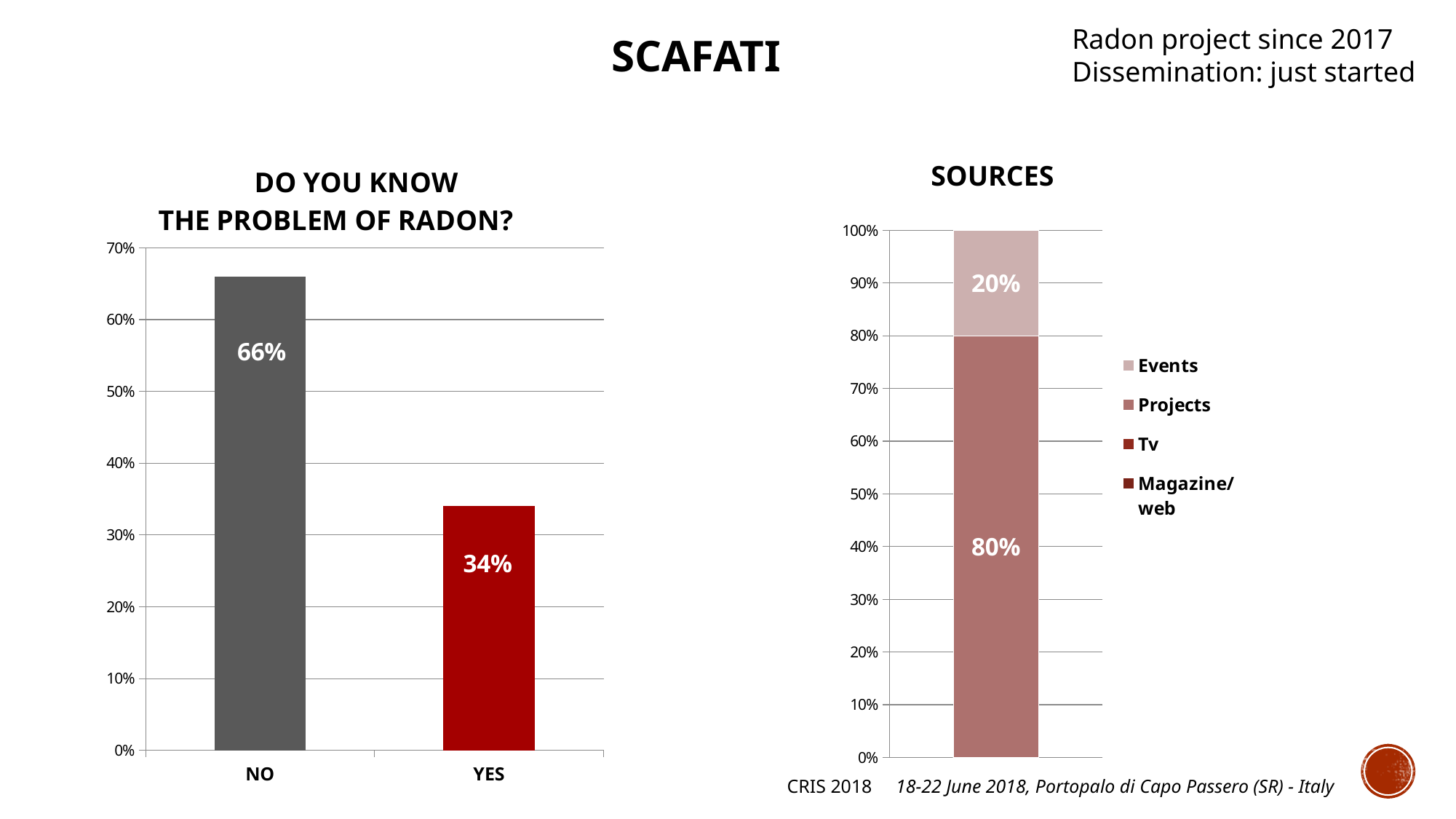
In the SOURCES chart, which legend entry is shown with the lightest colour? Events In the 'DO YOU KNOW THE PROBLEM OF RADON?' chart, what is the difference between the NO and YES values? 32% In the 'DO YOU KNOW THE PROBLEM OF RADON?' chart, how many categories are shown on the x axis? 2 In the 'DO YOU KNOW THE PROBLEM OF RADON?' chart, what is the value for YES? 34% In the 'DO YOU KNOW THE PROBLEM OF RADON?' chart, which category has the higher value? NO In the SOURCES chart, how many series does the legend list? 4 What kind of chart is the 'DO YOU KNOW THE PROBLEM OF RADON?' chart? bar chart In the SOURCES chart, what is the value for Events? 20% In the SOURCES chart, what is the value for Projects? 80% In the SOURCES chart, which is larger, Projects or Events? Projects In the SOURCES chart, what is the total of the stacked bar? 100% In the 'DO YOU KNOW THE PROBLEM OF RADON?' chart, what is the value for NO? 66%